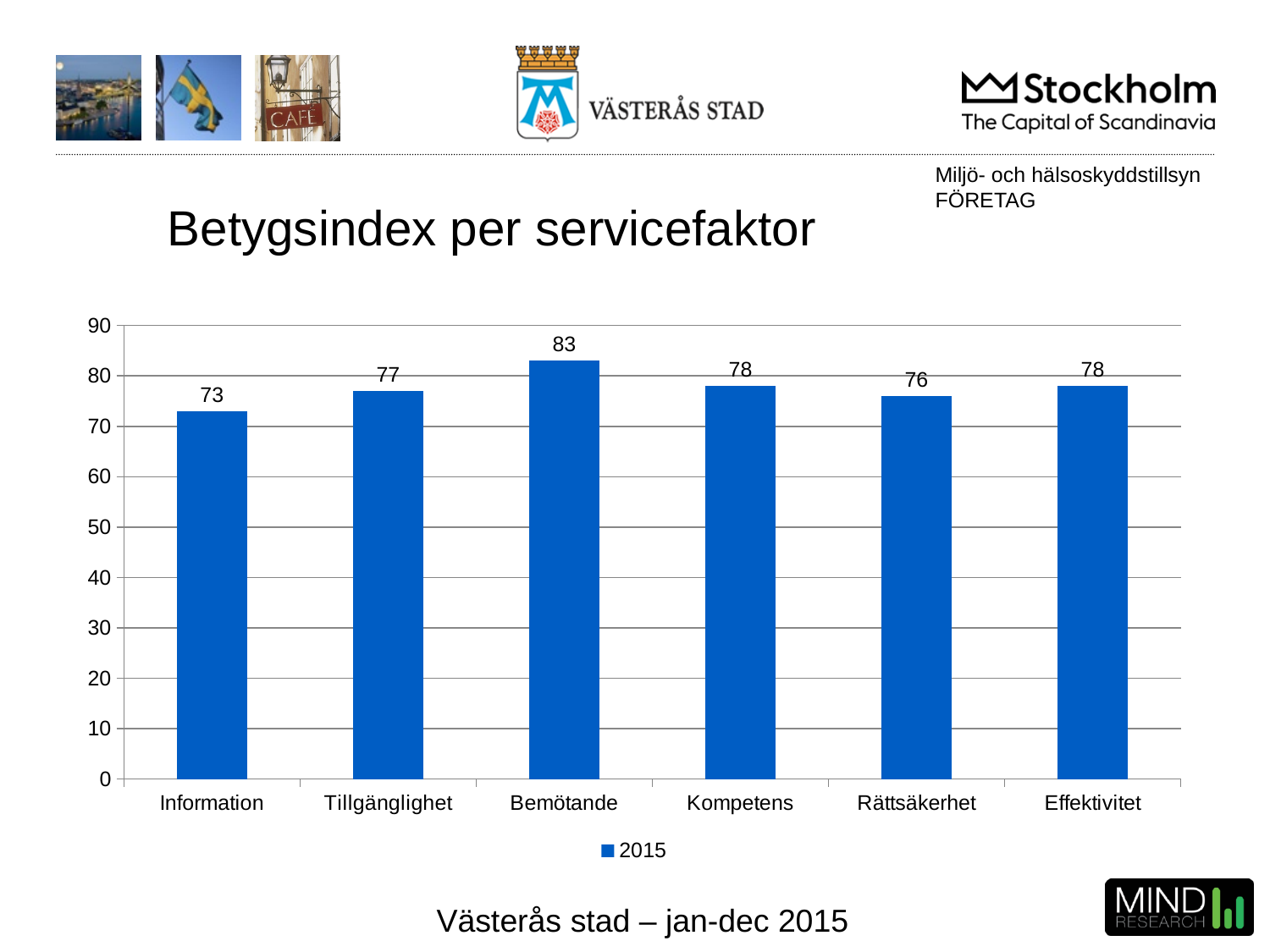
What is the title of the chart? Betygsindex per servicefaktor What is the value for Information? 73 Is the value for Kompetens greater or less than 70? greater What is the value for Rättsäkerhet? 76 What kind of chart is shown? bar chart How many service factors are shown on the x axis? 6 What is the value for Bemötande? 83 Which service factor has the highest value? Bemötande Which service factor has the lowest value? Information How many series does the legend list? 1 What is the difference between the values for Bemötande and Information? 10 Which is larger, the value for Tillgänglighet or the value for Rättsäkerhet? Tillgänglighet